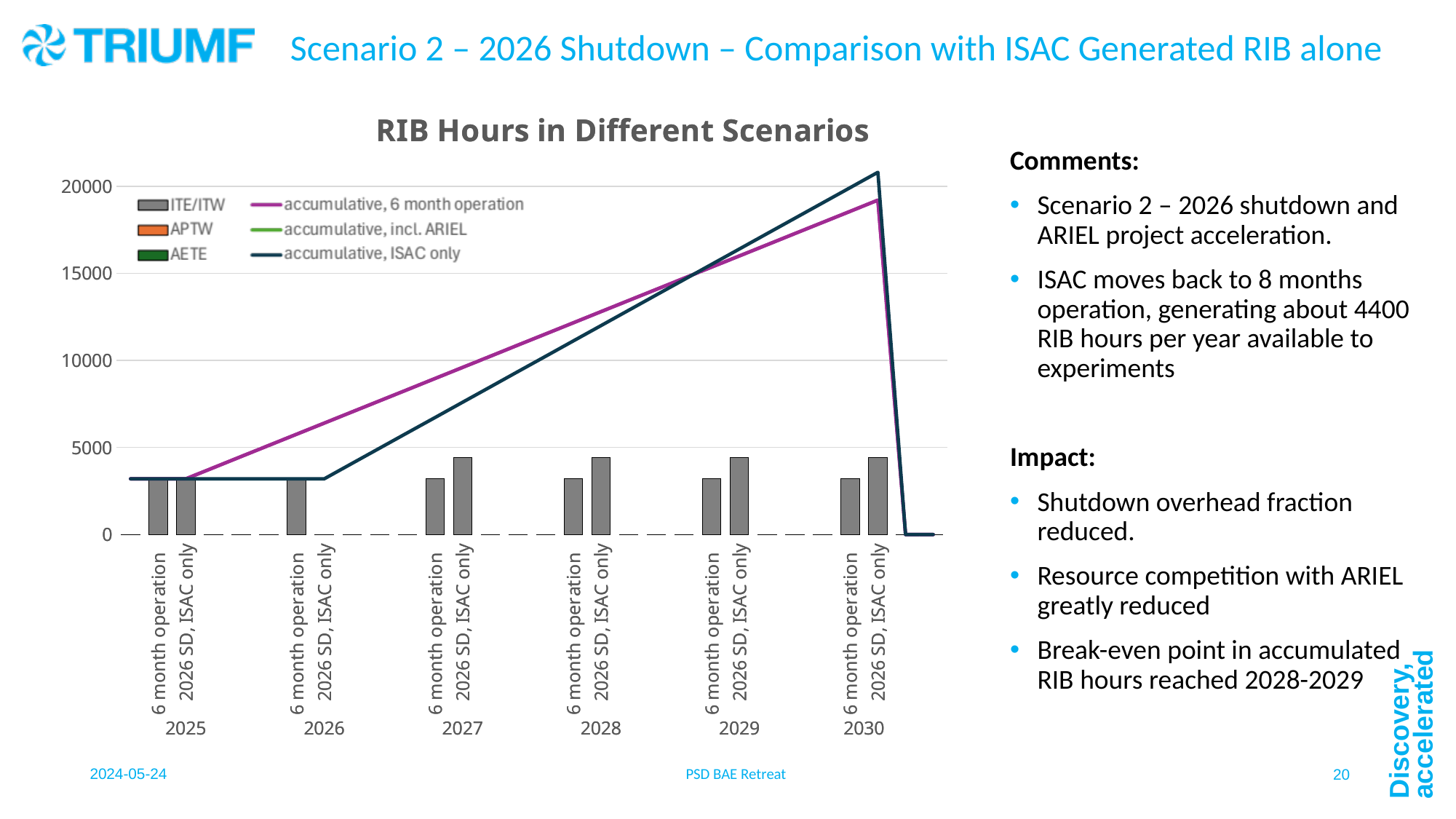
How many years are shown along the x axis of the chart? 6 How many series does the chart legend list? 6 In 2027, which ITE/ITW bar is taller: '6 month operation' or '2026 SD, ISAC only'? 2026 SD, ISAC only Is the value of the 'accumulative, 6 month operation' line at 2027 greater or less than 5000? greater Is the value of the 'accumulative, ISAC only' line at its 2030 peak greater or less than 20000? greater Is the ITE/ITW bar for '2026 SD, ISAC only' in 2027 greater or less than 5000? less What kind of chart is shown on the slide? Combined bar and line chart What is the title of the chart? RIB Hours in Different Scenarios Does the 'accumulative, 6 month operation' line rise or fall from 2025 to 2030? rise At 2030, which line reaches a higher peak: 'accumulative, 6 month operation' or 'accumulative, ISAC only'? accumulative, ISAC only